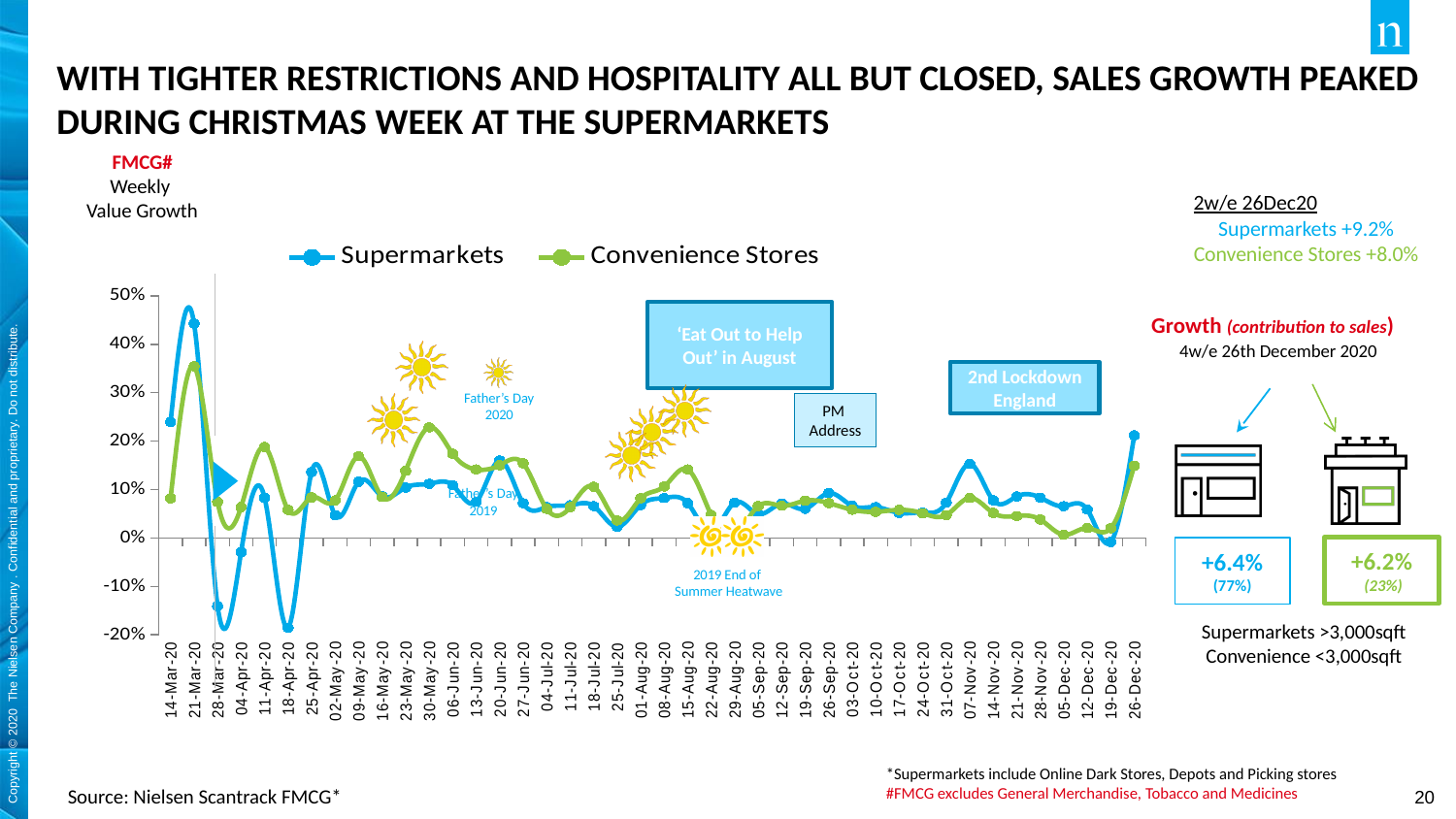
How many series does the chart legend list? 2 Is the Convenience Stores value for 21-Mar-20 greater or less than 30%? greater What kind of chart is shown on the slide? line chart On 28-Mar-20, which series has the higher value, Supermarkets or Convenience Stores? Convenience Stores What are the two series named in the chart legend? Supermarkets and Convenience Stores Is the Supermarkets value for 21-Mar-20 greater or less than 40%? greater According to the annotation on the slide, what was the Supermarkets weekly value growth for 2w/e 26Dec20? +9.2% On which date does the Supermarkets series reach its highest value? 21-Mar-20 Is the Supermarkets value for 26-Dec-20 greater or less than 10%? greater On 21-Mar-20, which series has the higher value, Supermarkets or Convenience Stores? Supermarkets Does the Supermarkets series rise or fall between 14-Mar-20 and 21-Mar-20? rise